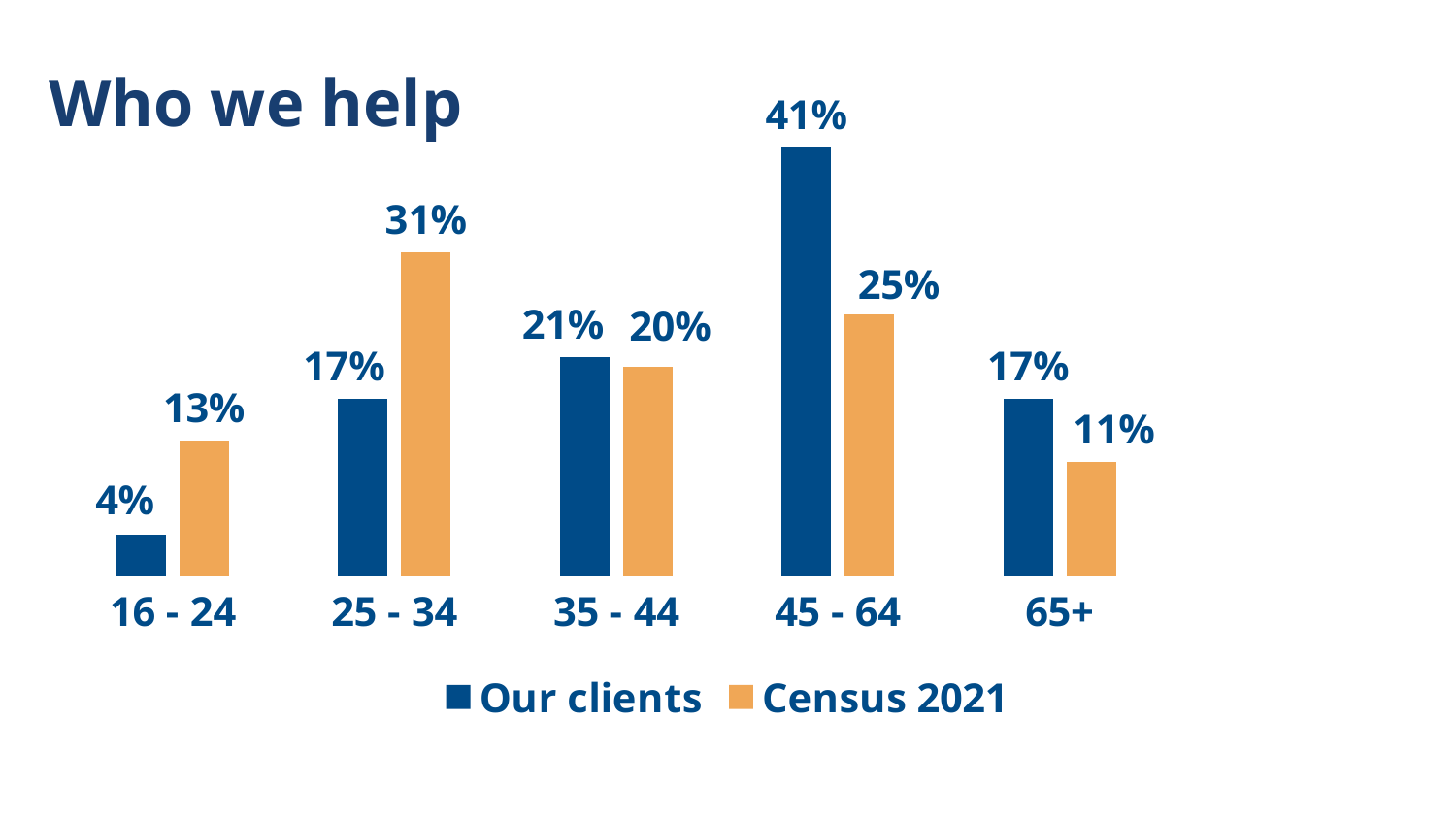
Which age group has the highest value for Our clients? 45 - 64 Which age group has the lowest value for Census 2021? 65+ What is the title of the slide? Who we help Which is larger in the 25 - 34 age group, Our clients or Census 2021? Census 2021 How many age groups are shown on the chart? 5 What is the value for Census 2021 in the 65+ age group? 11% What is the value for Our clients in the 16 - 24 age group? 4% How many series does the legend list? 2 What is the value for Census 2021 in the 25 - 34 age group? 31% What kind of chart is shown on the slide? Bar chart What is the value for Our clients in the 45 - 64 age group? 41% What is the difference between Our clients and Census 2021 in the 45 - 64 age group? 16%